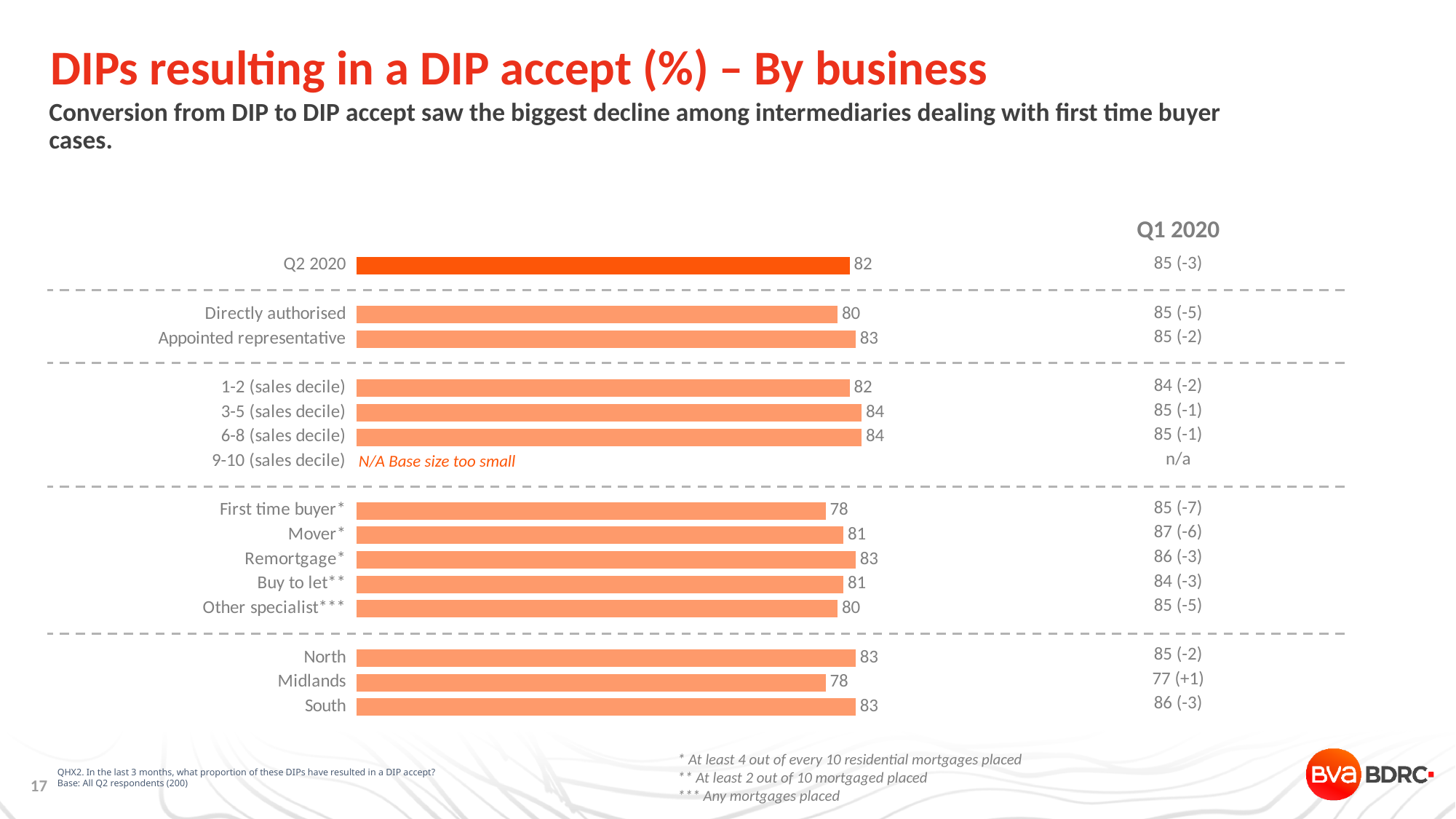
What is the value for Q2 2020 overall? 82 What is the value for Appointed representative? 83 What is the difference between the values for Directly authorised and Appointed representative? 3 What is the value for First time buyer? 78 What kind of chart is shown on the slide? Bar chart Which region has the lowest value? Midlands What is the value for Midlands? 78 Which of the sales decile categories with a plotted bar has the lowest value? 1-2 (sales decile) Which category is marked as N/A because the base size is too small? 9-10 (sales decile) What is the difference between the values for Remortgage and First time buyer? 5 Which is larger, the value for Mover or the value for Remortgage? Remortgage What is the Q1 2020 value shown for Midlands? 77 (+1)